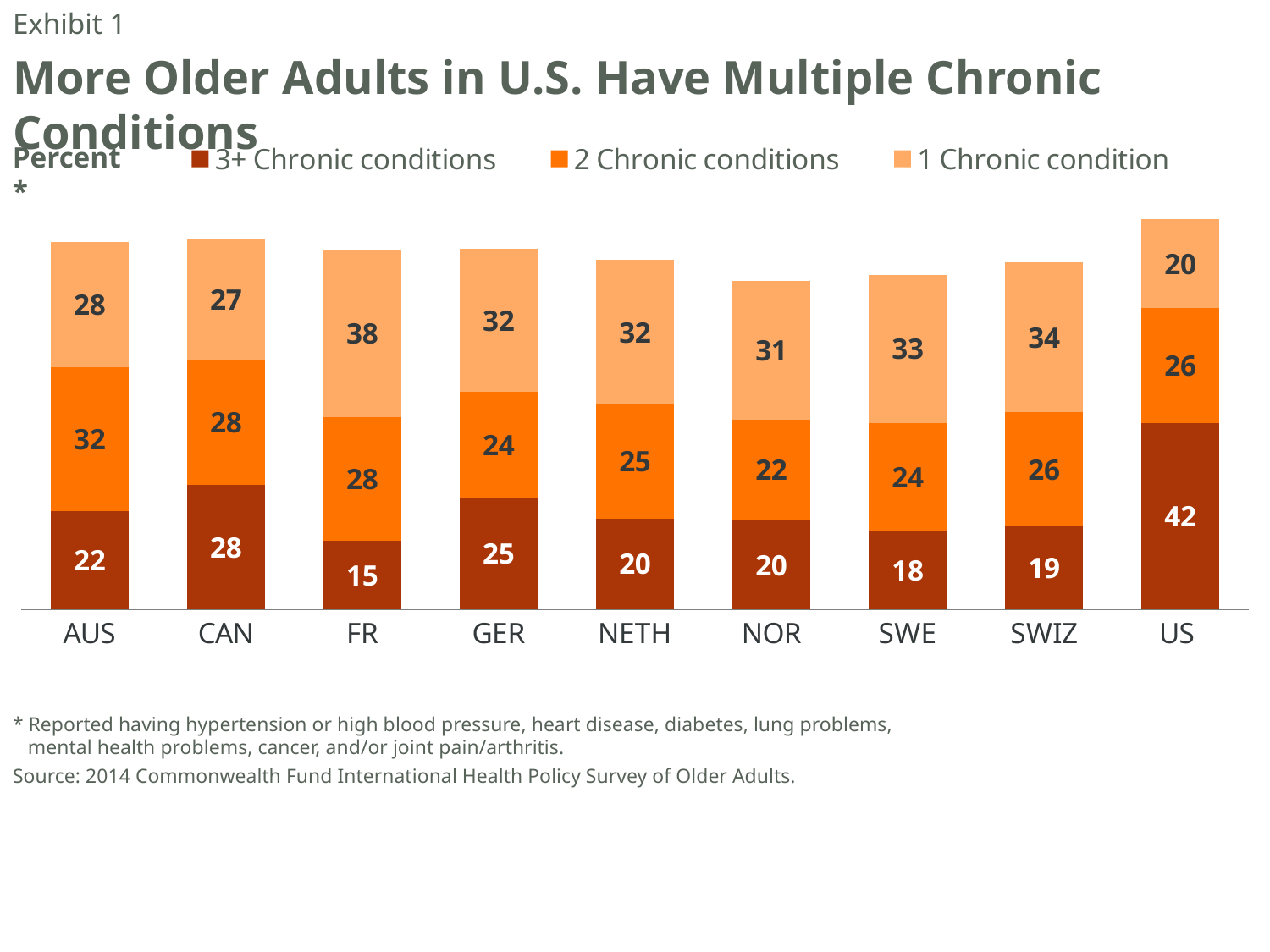
What is the difference between the 3+ Chronic conditions values for the US and CAN? 14 What is the total of the stacked bar for NOR? 73 What kind of chart is shown on the slide? Stacked bar chart How many countries are shown on the x axis? 9 What is the value for 1 Chronic condition for FR? 38 What is the total of the stacked bar for the US? 88 How many series does the legend list? 3 Which country has the highest value for 3+ Chronic conditions? US Which is larger, the 2 Chronic conditions value for AUS or for GER? AUS What is the value for 3+ Chronic conditions for the US? 42 Which country has the lowest value for 3+ Chronic conditions? FR What is the value for 2 Chronic conditions for NETH? 25